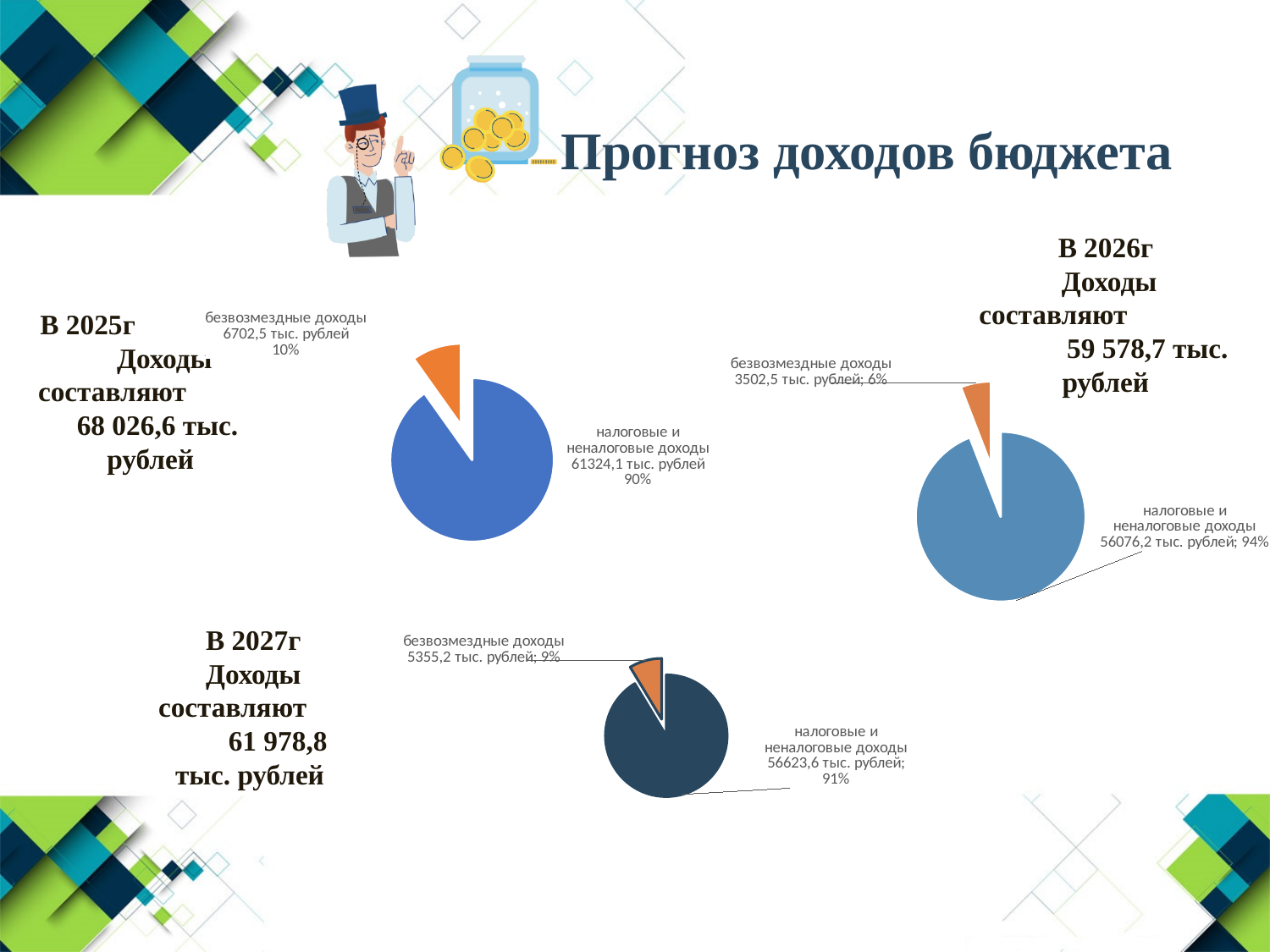
In the 2025 pie chart (left), which is larger: безвозмездные доходы or налоговые и неналоговые доходы? налоговые и неналоговые доходы What kind of chart is used for the 2026 data (right)? pie chart How many pie charts are shown on the slide? 3 In the 2026 pie chart (right), which slice is the smallest? безвозмездные доходы In the 2026 pie chart (right), what value is shown for безвозмездные доходы? 3502,5 тыс. рублей In the 2027 pie chart (bottom), what value is shown for безвозмездные доходы? 5355,2 тыс. рублей In the 2026 pie chart (right), what share of the pie is налоговые и неналоговые доходы? 94% How many slices does the 2025 pie chart (left) have? 2 In the 2025 pie chart (left), what share of the pie is безвозмездные доходы? 10% In the 2027 pie chart (bottom), what share of the pie is налоговые и неналоговые доходы? 91% In the 2025 pie chart (left), what value is shown for налоговые и неналоговые доходы? 61324,1 тыс. рублей In the 2027 pie chart (bottom), which slice is the largest? налоговые и неналоговые доходы